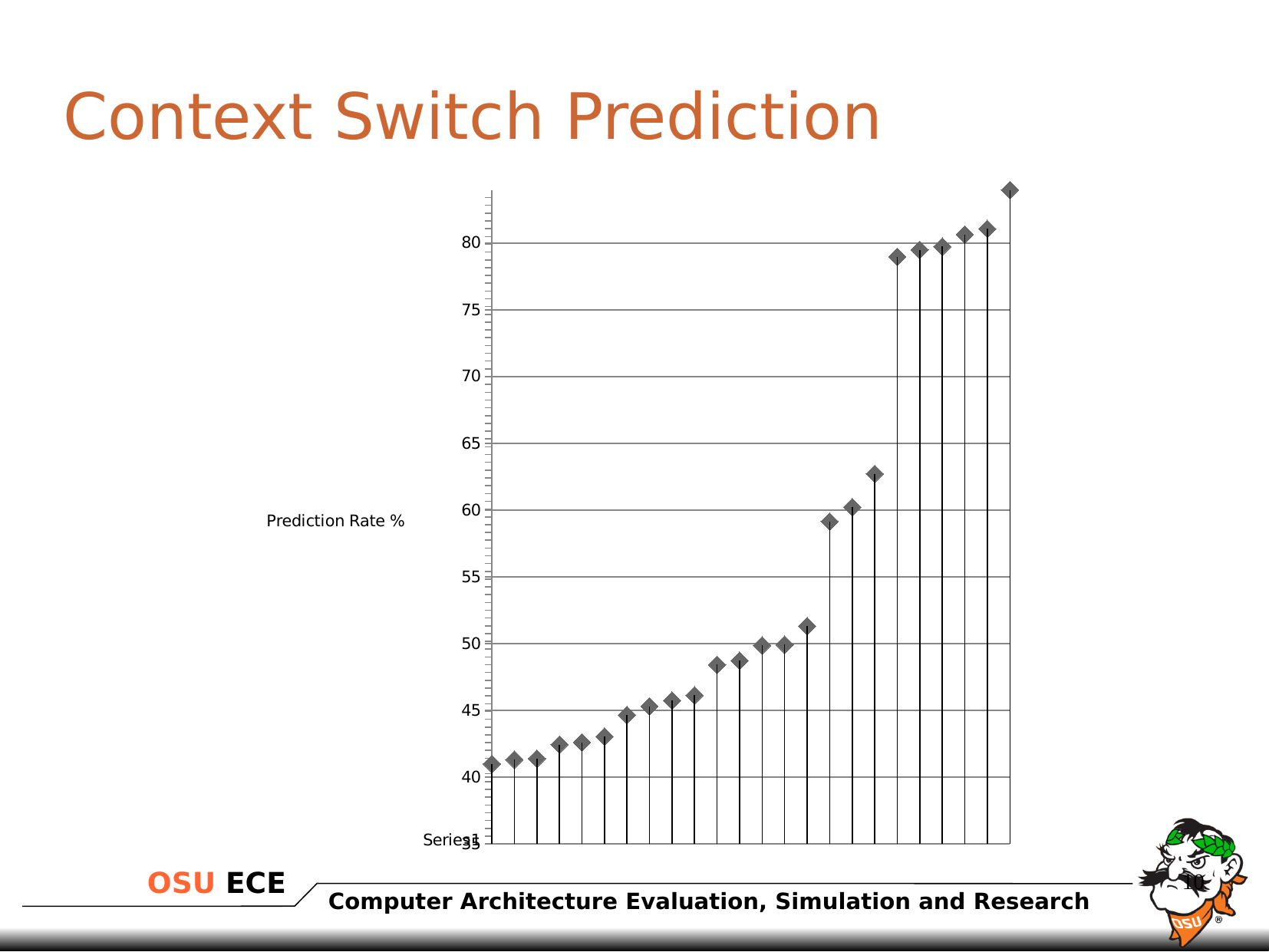
Is the value of the leftmost data point greater or less than 45? less What kind of chart is shown on the slide? Bar chart (thin vertical bars topped with diamond markers) Do the plotted values rise or fall from left to right along the x axis? Rise What is the name of the series shown in the chart? Series1 What is the label of the vertical axis? Prediction Rate % Which data point has the highest prediction rate, the leftmost or the rightmost? The rightmost What is the lowest value shown on the vertical axis? 35 How many data points are plotted in the chart? 24 Is the value of the rightmost data point greater or less than 80? greater How many data points have a prediction rate above 75? 6 Which data point has the lowest prediction rate, the leftmost or the rightmost? The leftmost How many data points have a prediction rate between 55 and 65? 3